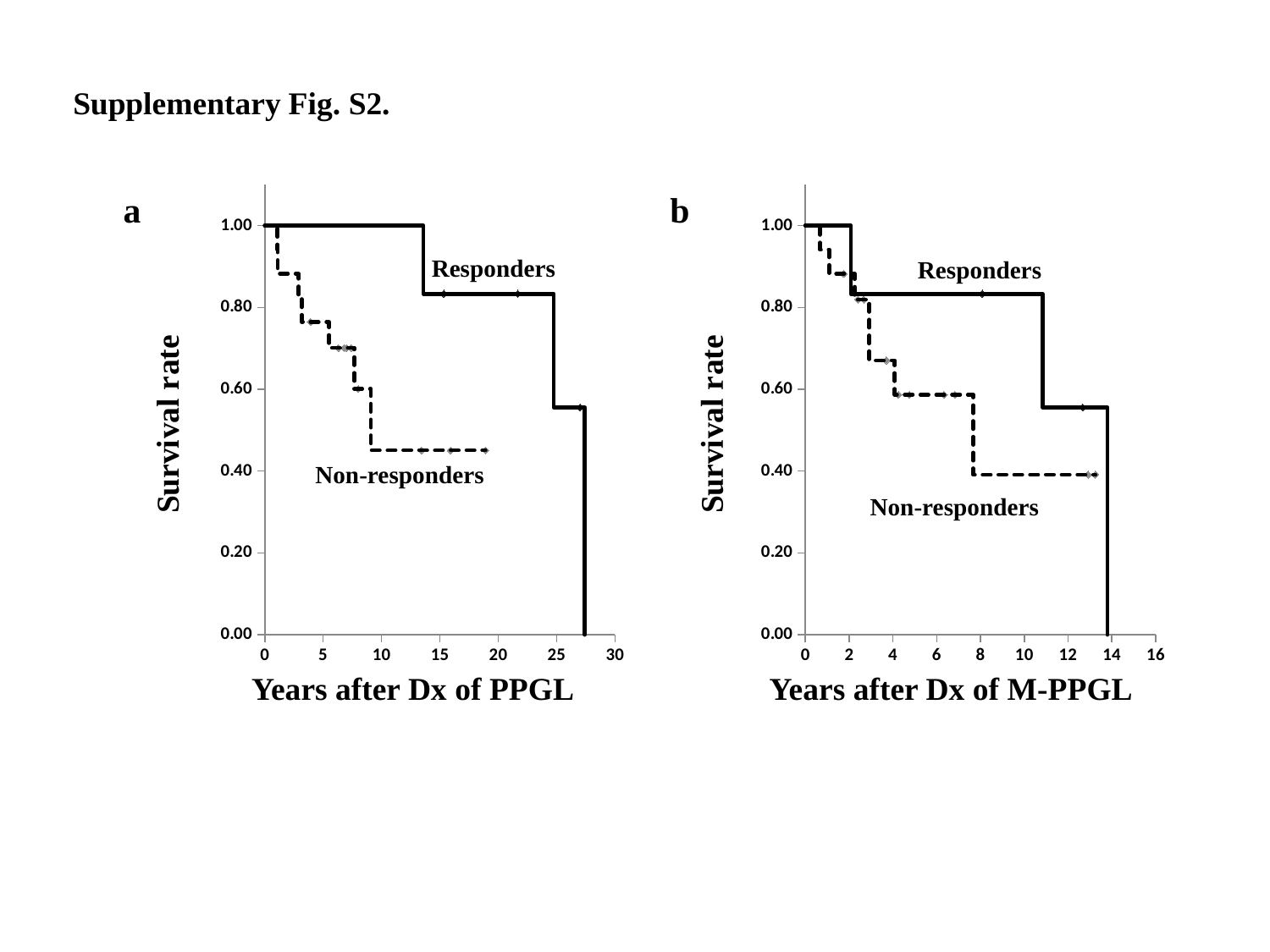
How many series are plotted in panel b (Years after Dx of M-PPGL)? 2 What kind of chart is panel a (Years after Dx of PPGL)? line chart In panel a (Years after Dx of PPGL), is the survival rate for Responders at 10 years greater or less than 0.80? greater In panel b (Years after Dx of M-PPGL), does the survival rate for Non-responders rise or fall as years increase? fall In panel a (Years after Dx of PPGL), what is the label of the y axis? Survival rate In panel b, which series is drawn with a dashed line? Non-responders In panel b (Years after Dx of M-PPGL), is the survival rate for Responders at 12 years greater or less than 0.80? less In panel a (Years after Dx of PPGL), at 15 years, which series has the higher survival rate, Responders or Non-responders? Responders In panel b (Years after Dx of M-PPGL), is the survival rate for Responders at 6 years greater or less than 0.60? greater